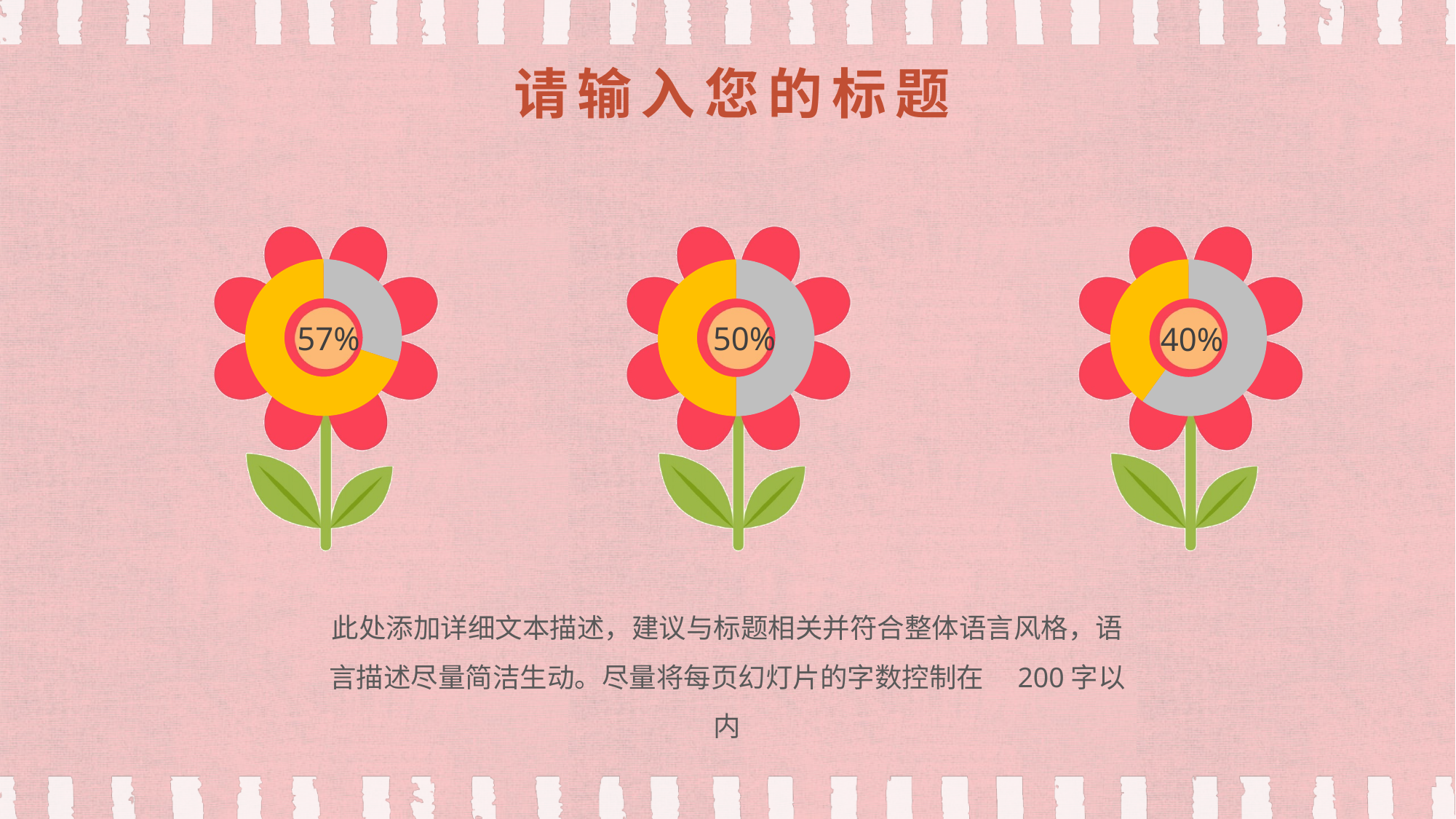
How many flower charts are on the slide? 3 What is the difference between the percentage in the middle flower chart and the percentage in the right flower chart? 10% Do the percentages rise or fall going from the left flower chart to the right flower chart? fall Which of the three flower charts shows the lowest percentage: left, middle or right? right What colour is the filled (value) portion of each flower chart? yellow What percentage is shown in the left flower chart? 57% Which of the three flower charts shows the highest percentage: left, middle or right? left What percentage is shown in the middle flower chart? 50% What kind of chart is used inside each flower? doughnut chart Which is larger, the percentage in the left flower chart or the percentage in the middle flower chart? left What percentage is shown in the right flower chart? 40% What is the difference between the percentage in the left flower chart and the percentage in the right flower chart? 17%